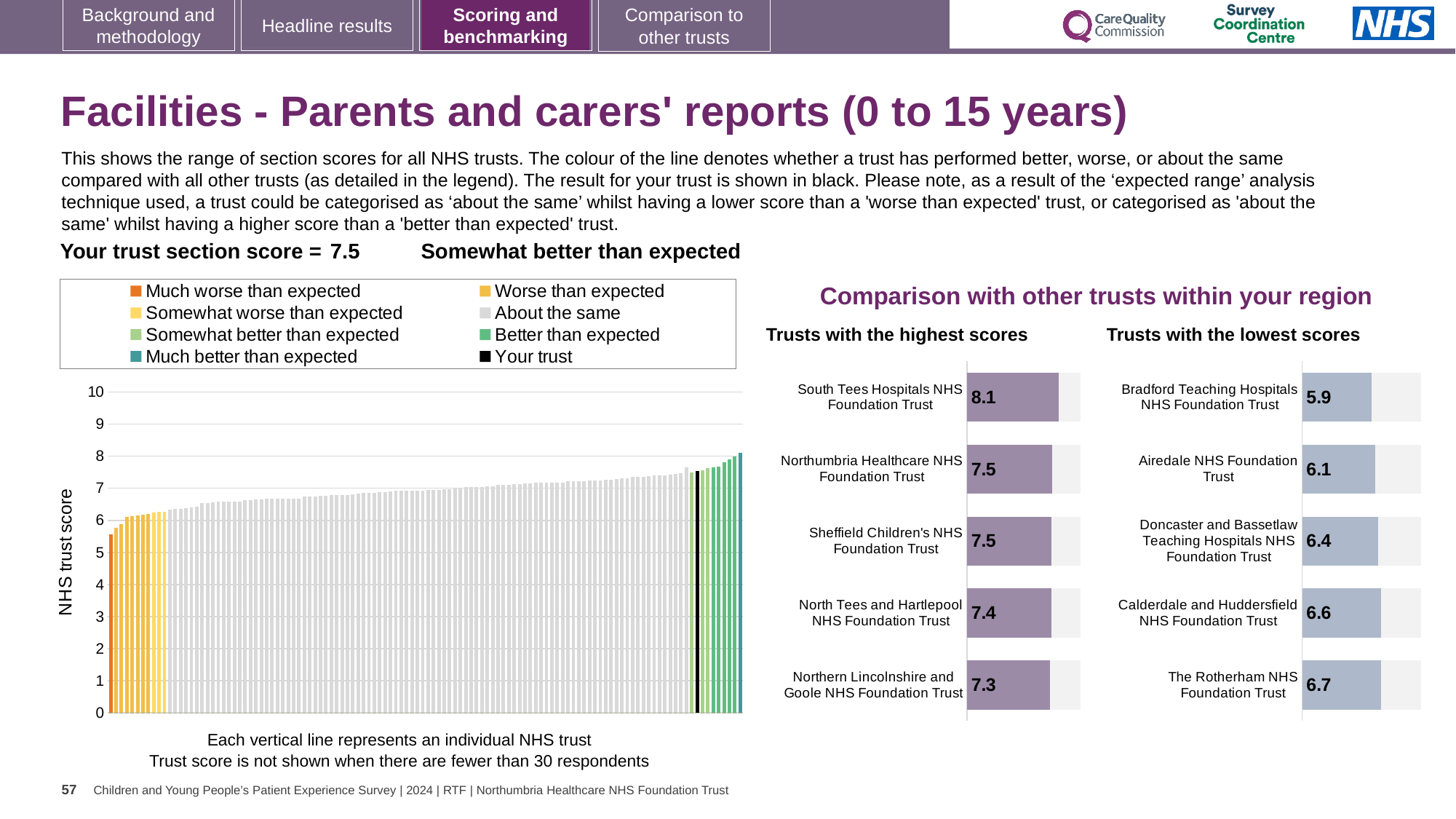
In the 'Trusts with the highest scores' chart, what is the score for South Tees Hospitals NHS Foundation Trust? 8.1 In the 'Trusts with the highest scores' chart, what is the difference between the scores of South Tees Hospitals NHS Foundation Trust and Northern Lincolnshire and Goole NHS Foundation Trust? 0.8 In the 'Trusts with the highest scores' chart, which trust has the highest score? South Tees Hospitals NHS Foundation Trust In the 'Trusts with the lowest scores' chart, what is the score for Bradford Teaching Hospitals NHS Foundation Trust? 5.9 How many entries does the legend of the main 'NHS trust score' chart list? 8 What kind of chart is the main 'NHS trust score' chart? bar chart In the main 'NHS trust score' chart, is the value of the lowest (leftmost) bar greater or less than 6? less In the 'Trusts with the lowest scores' chart, which has the larger score: Airedale NHS Foundation Trust or Calderdale and Huddersfield NHS Foundation Trust? Calderdale and Huddersfield NHS Foundation Trust In the main 'NHS trust score' chart, what is the section score for your trust? 7.5 In the 'Trusts with the lowest scores' chart, what is the score for Doncaster and Bassetlaw Teaching Hospitals NHS Foundation Trust? 6.4 How many trusts are shown in the 'Trusts with the highest scores' chart? 5 In the 'Trusts with the lowest scores' chart, which trust has the lowest score? Bradford Teaching Hospitals NHS Foundation Trust